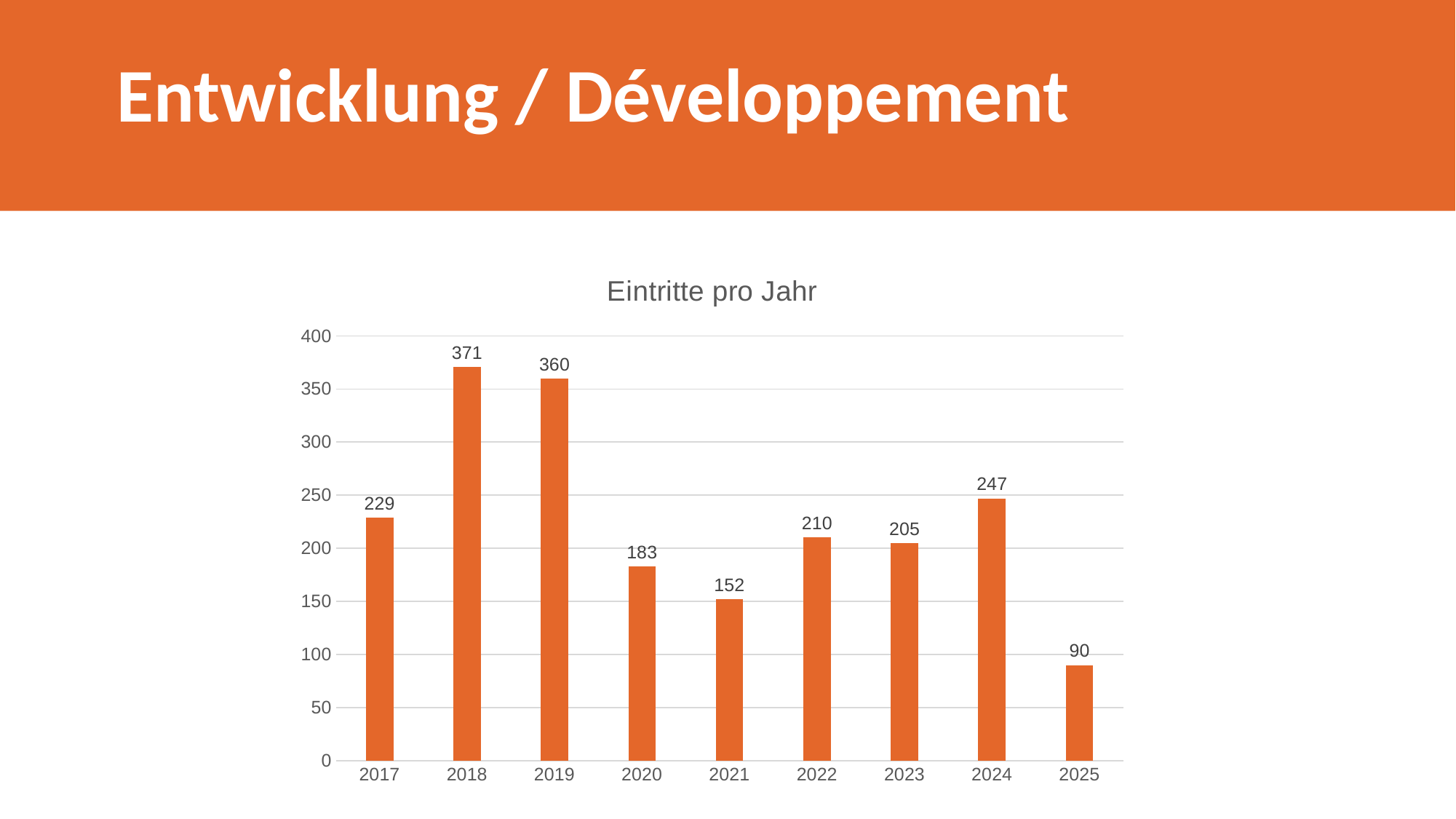
What is the value for 2018? 371 Which is larger, the value for 2017 or the value for 2024? 2024 What is the difference between the values for 2018 and 2019? 11 How many years are shown on the x axis? 9 Is the value for 2020 greater or less than 200? less What is the value for 2025? 90 What kind of chart is shown? bar chart What is the value for 2021? 152 What is the difference between the values for 2024 and 2025? 157 Which year has the highest value? 2018 Which year has the lowest value? 2025 What is the title of the chart? Eintritte pro Jahr